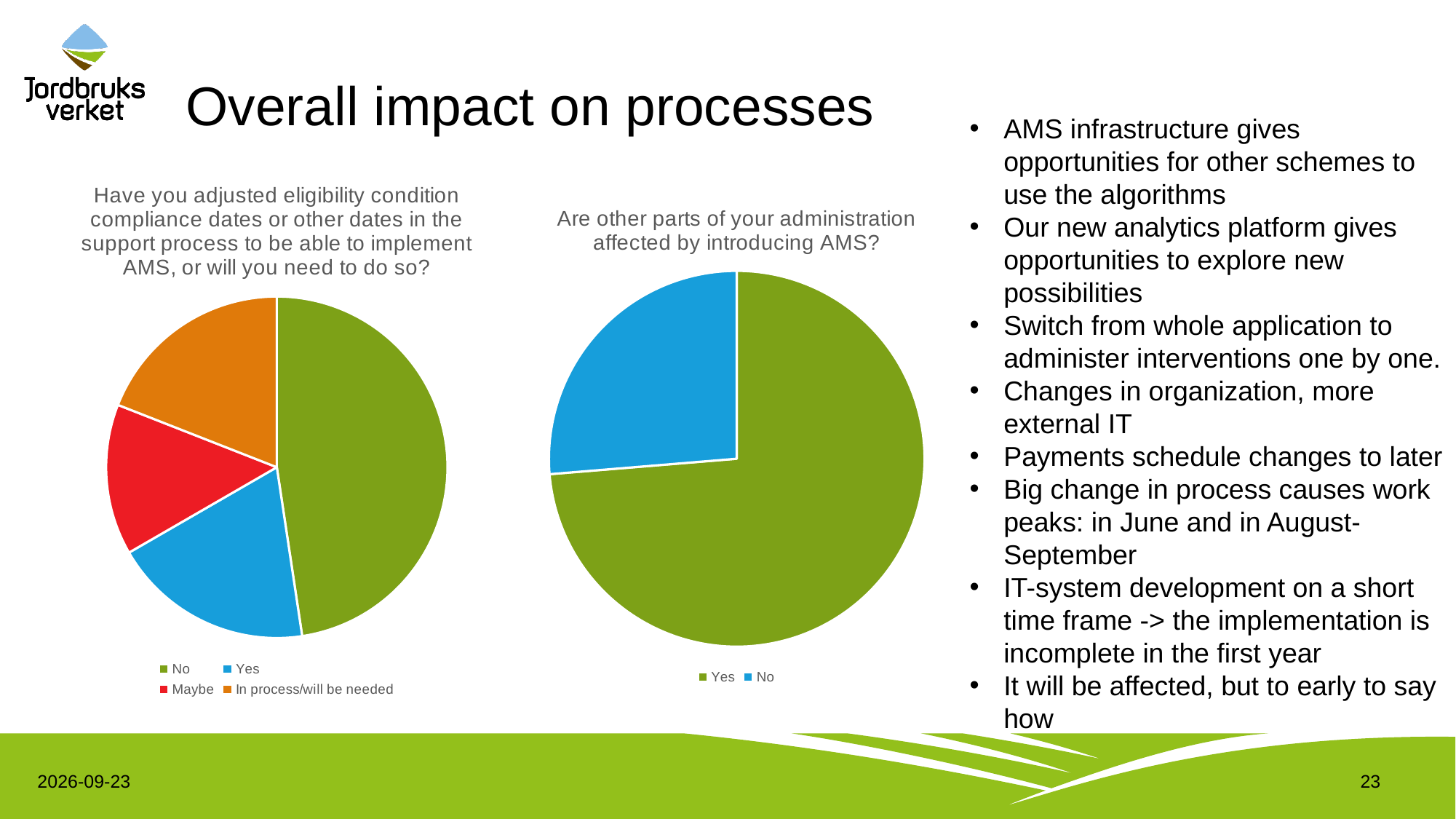
What kind of chart is the right chart titled "Are other parts of your administration affected by introducing AMS?"? pie chart In the left pie chart, which category has the largest slice? No In the left pie chart, which legend entry is shown in orange? In process/will be needed In the right pie chart, which category has the largest slice? Yes In the left pie chart, how many slices (categories) are there? 4 In the left pie chart, which slice is larger, "No" or "Maybe"? No In the right pie chart, which category has the smallest slice? No In the left pie chart, which slice is larger, "No" or "Yes"? No What kind of chart is the left chart titled "Have you adjusted eligibility condition compliance dates..."? pie chart In the right pie chart, which slice is larger, "Yes" or "No"? Yes In the right pie chart, how many slices (categories) are there? 2 In the left pie chart, what colour is the "Maybe" slice? red